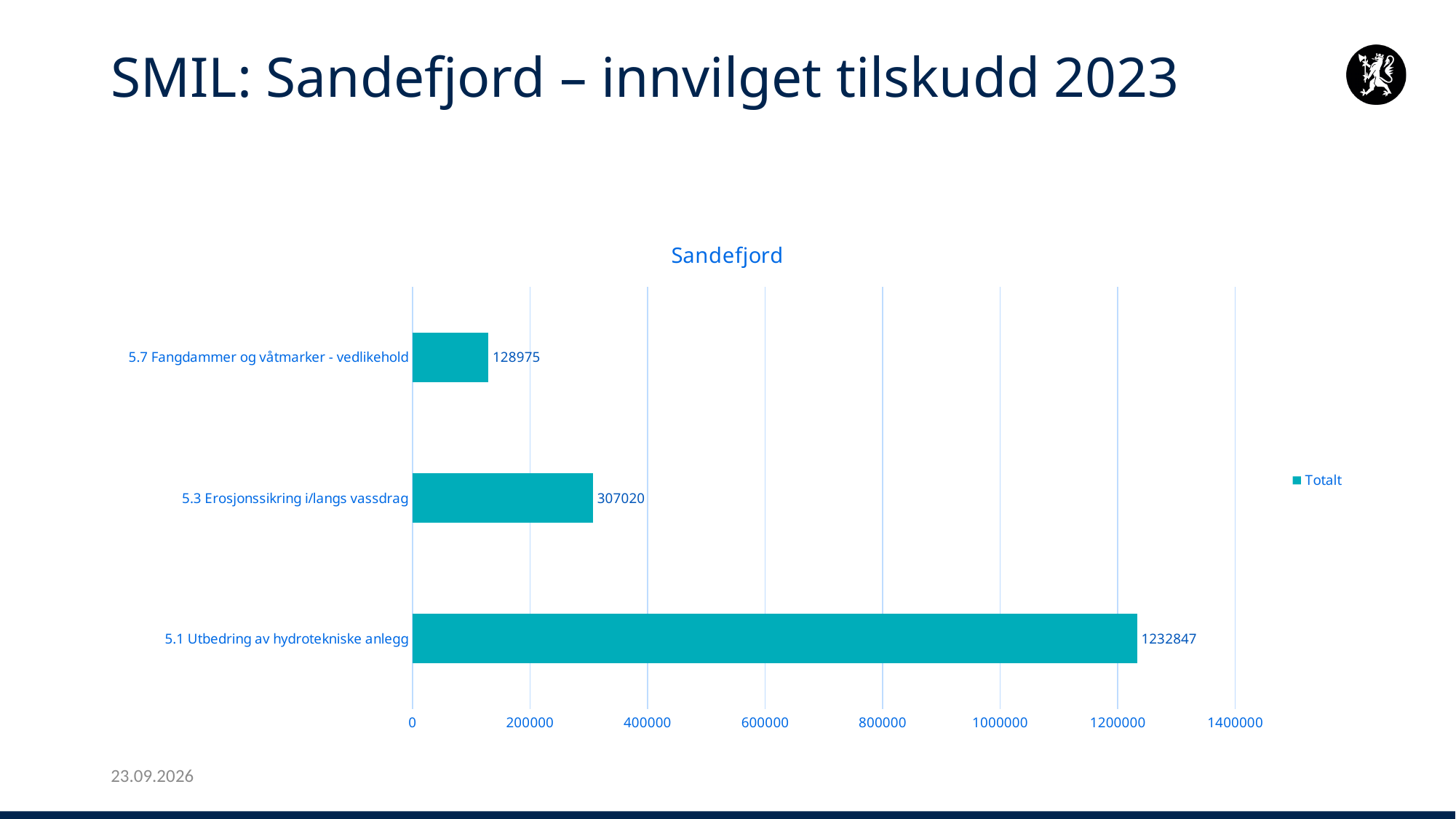
Which is larger, the value for 5.3 Erosjonssikring i/langs vassdrag or the value for 5.7 Fangdammer og våtmarker - vedlikehold? 5.3 Erosjonssikring i/langs vassdrag Which category has the lowest value? 5.7 Fangdammer og våtmarker - vedlikehold What is the value for 5.3 Erosjonssikring i/langs vassdrag? 307020 Is the value for 5.1 Utbedring av hydrotekniske anlegg greater or less than 1000000? greater What is the title of the chart? Sandefjord What is the difference between the values for 5.3 Erosjonssikring i/langs vassdrag and 5.7 Fangdammer og våtmarker - vedlikehold? 178045 What is the difference between the values for 5.1 Utbedring av hydrotekniske anlegg and 5.3 Erosjonssikring i/langs vassdrag? 925827 What is the value for 5.7 Fangdammer og våtmarker - vedlikehold? 128975 How many categories are shown in the chart? 3 What kind of chart is shown on the slide? bar chart What is the value for 5.1 Utbedring av hydrotekniske anlegg? 1232847 Which category has the highest value? 5.1 Utbedring av hydrotekniske anlegg